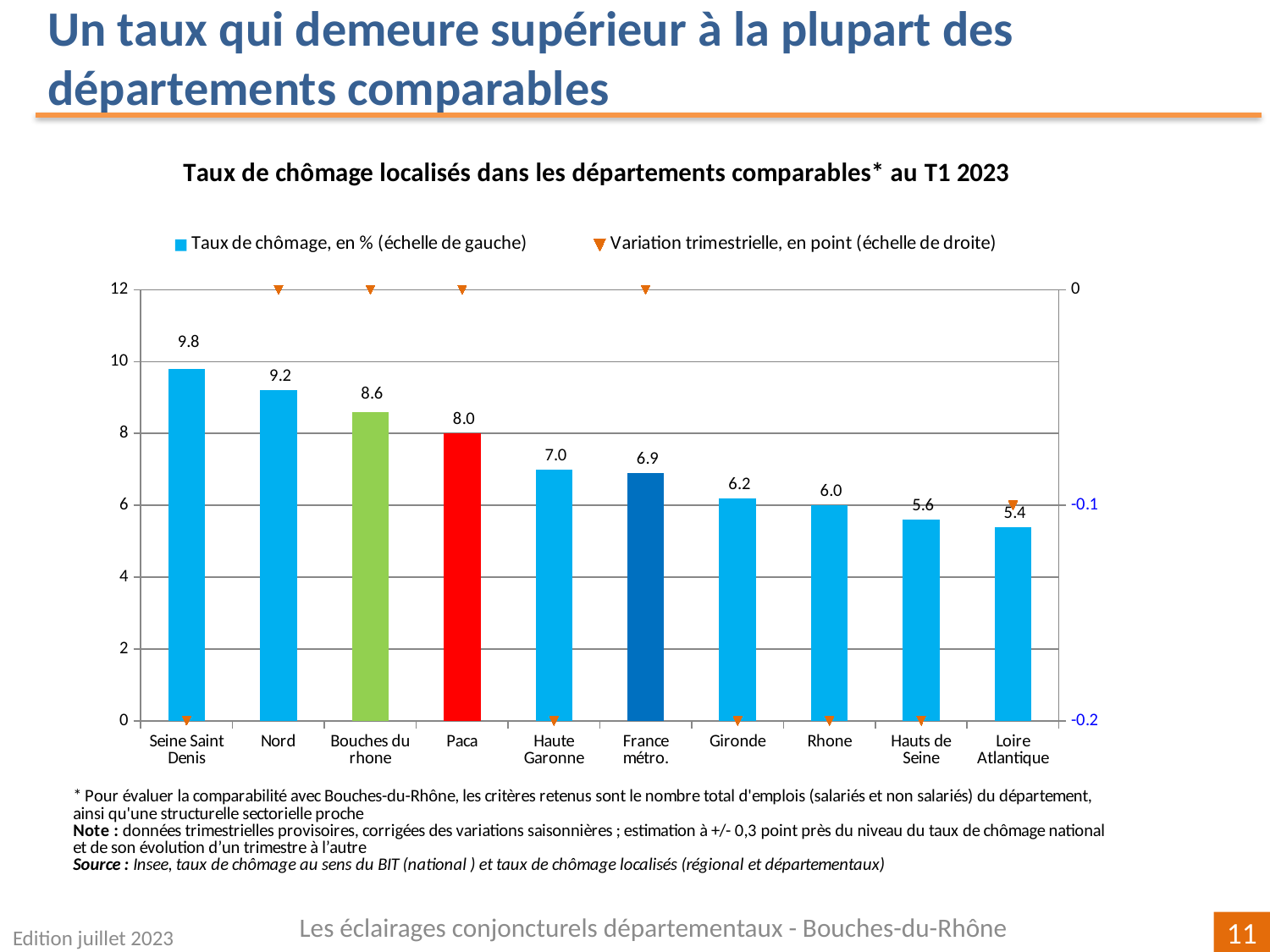
What is the unemployment rate shown for France métro.? 6.9 How many departments or areas are shown on the x axis of the chart? 10 What is the difference between the unemployment rates of Bouches du rhone and Paca? 0.6 Which department has the lowest unemployment rate on the chart? Loire Atlantique What kind of chart is used to show the unemployment rates? Bar chart Which department has the highest unemployment rate on the chart? Seine Saint Denis How many series does the legend list? 2 Do the unemployment rates rise or fall from left to right along the x axis? Fall What is the quarterly variation (variation trimestrielle) shown for Loire Atlantique on the right-hand scale? -0.1 What is the difference between the unemployment rates of Seine Saint Denis and Nord? 0.6 Which has a higher unemployment rate, Gironde or Rhone? Gironde What is the unemployment rate (taux de chômage) shown for Bouches du rhone? 8.6